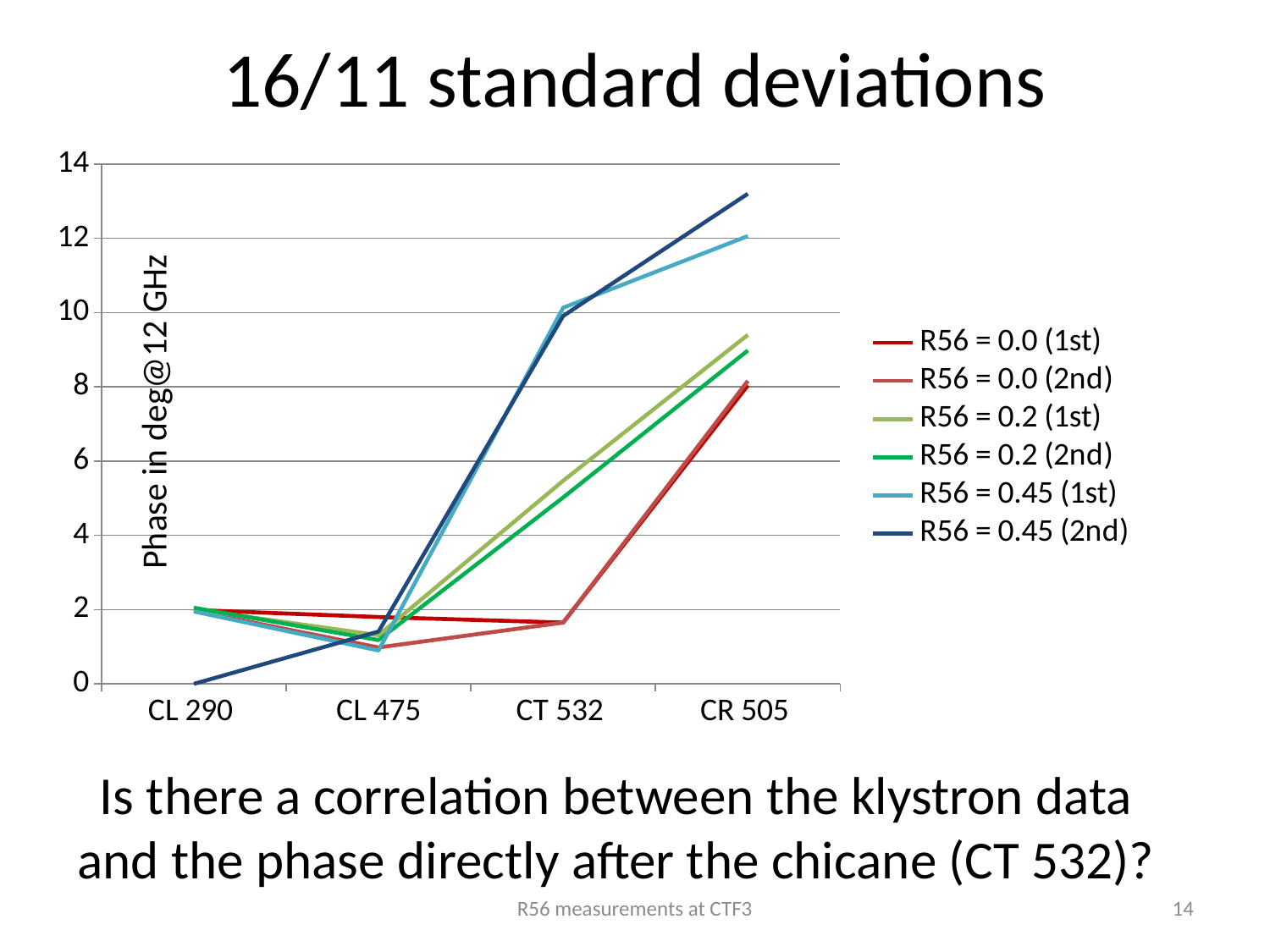
Is the value for R56 = 0.0 (1st) at CR 505 greater or less than 10? less Which series has the highest value at CR 505? R56 = 0.45 (2nd) How many categories are shown on the x axis? 4 Is the value for R56 = 0.0 (2nd) at CT 532 greater or less than 4? less At CT 532, which is larger: the value for R56 = 0.45 (1st) or the value for R56 = 0.0 (1st)? R56 = 0.45 (1st) What kind of chart is shown on the slide? line chart How many series does the legend list? 6 Does the R56 = 0.45 (2nd) series rise or fall from CL 290 to CR 505? rise What is the label on the y axis of the chart? Phase in deg@12 GHz Is the value for R56 = 0.45 (2nd) at CR 505 greater or less than 12? greater Which series has the lowest value at CL 290? R56 = 0.45 (2nd)